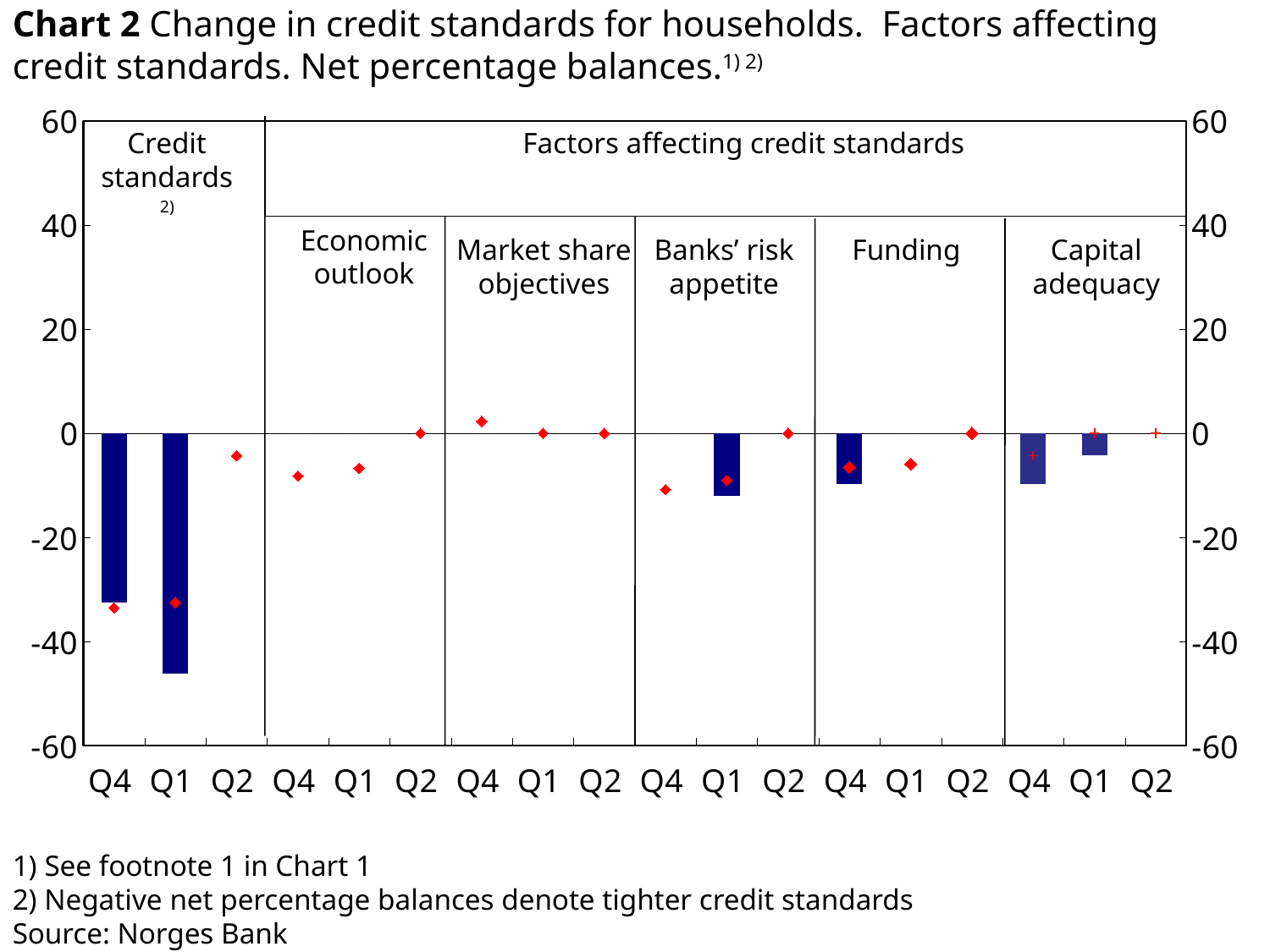
What is the maximum value shown on the vertical axis? 60 In the Banks' risk appetite panel, is the value of the Q1 bar greater or less than -20? greater In the Credit standards panel, is the value of the Q4 bar greater or less than -40? greater According to footnote 2, what do negative net percentage balances denote? tighter credit standards In the Economic outlook panel, do the values rise or fall from Q4 to Q2? rise In the Credit standards panel, which quarter has the lowest bar? Q1 What kind of chart is shown on the slide? bar chart How many quarters are shown in each panel of the chart? 3 How many factor panels are shown under 'Factors affecting credit standards'? 5 In the Credit standards panel, is the value of the Q4 bar greater or less than -20? less In the Credit standards panel, which bar is lower, Q4 or Q1? Q1